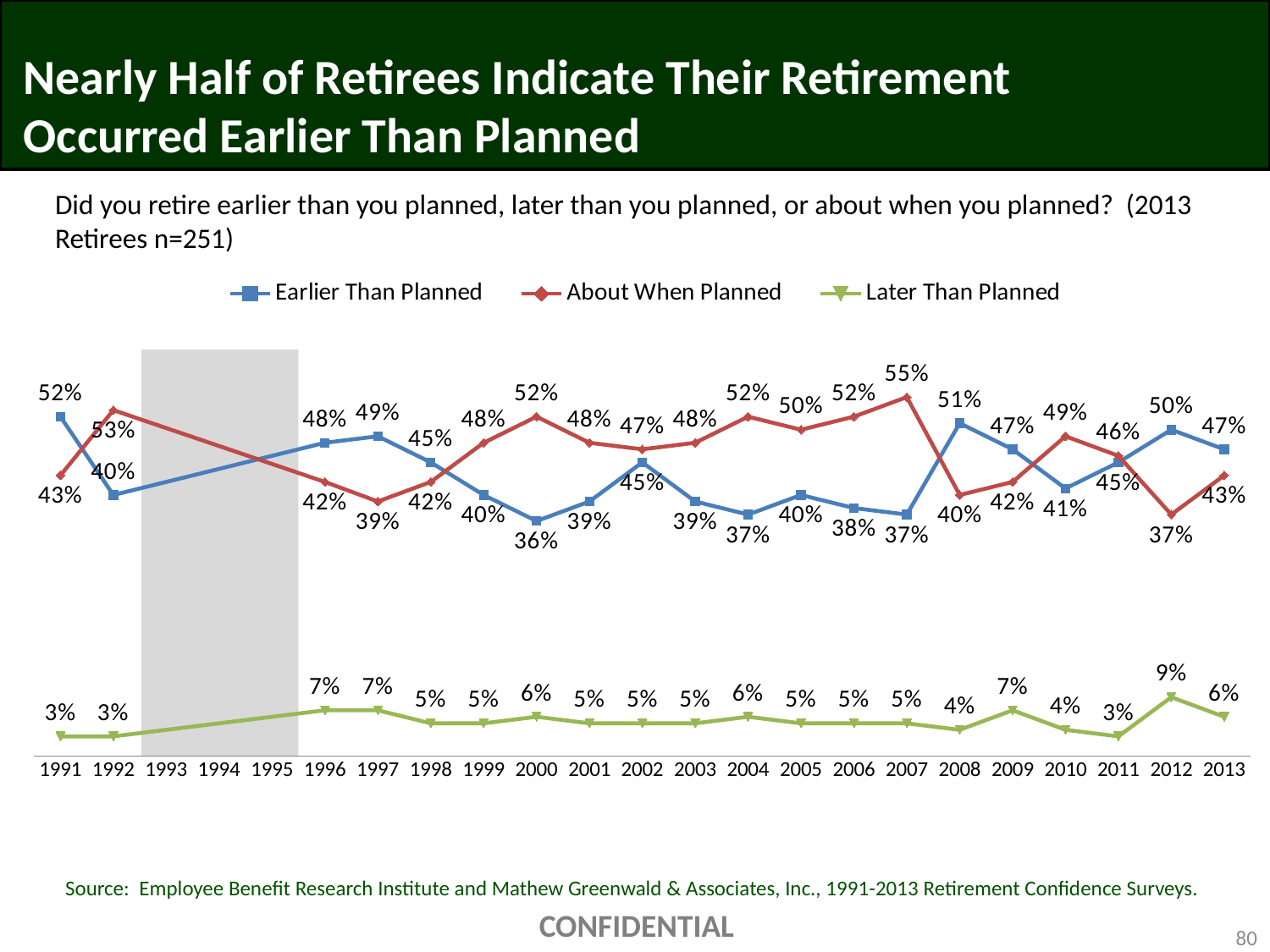
Does the Earlier Than Planned series rise or fall from 2010 to 2012? Rise How many series does the legend list? 3 Which is larger in 2008: Earlier Than Planned or About When Planned? Earlier Than Planned Which series is plotted in green? Later Than Planned How many year labels appear on the x axis? 23 In which year does the Earlier Than Planned series reach its lowest value? 2000 What is the value for Later Than Planned in 2012? 9% In which year does the About When Planned series reach its highest value? 2007 What percentage of retirees said they retired Earlier Than Planned in 2013? 47% What is the difference between About When Planned and Earlier Than Planned in 2007? 18 percentage points What kind of chart is shown on the slide? Line chart What is the value for About When Planned in 2007? 55%